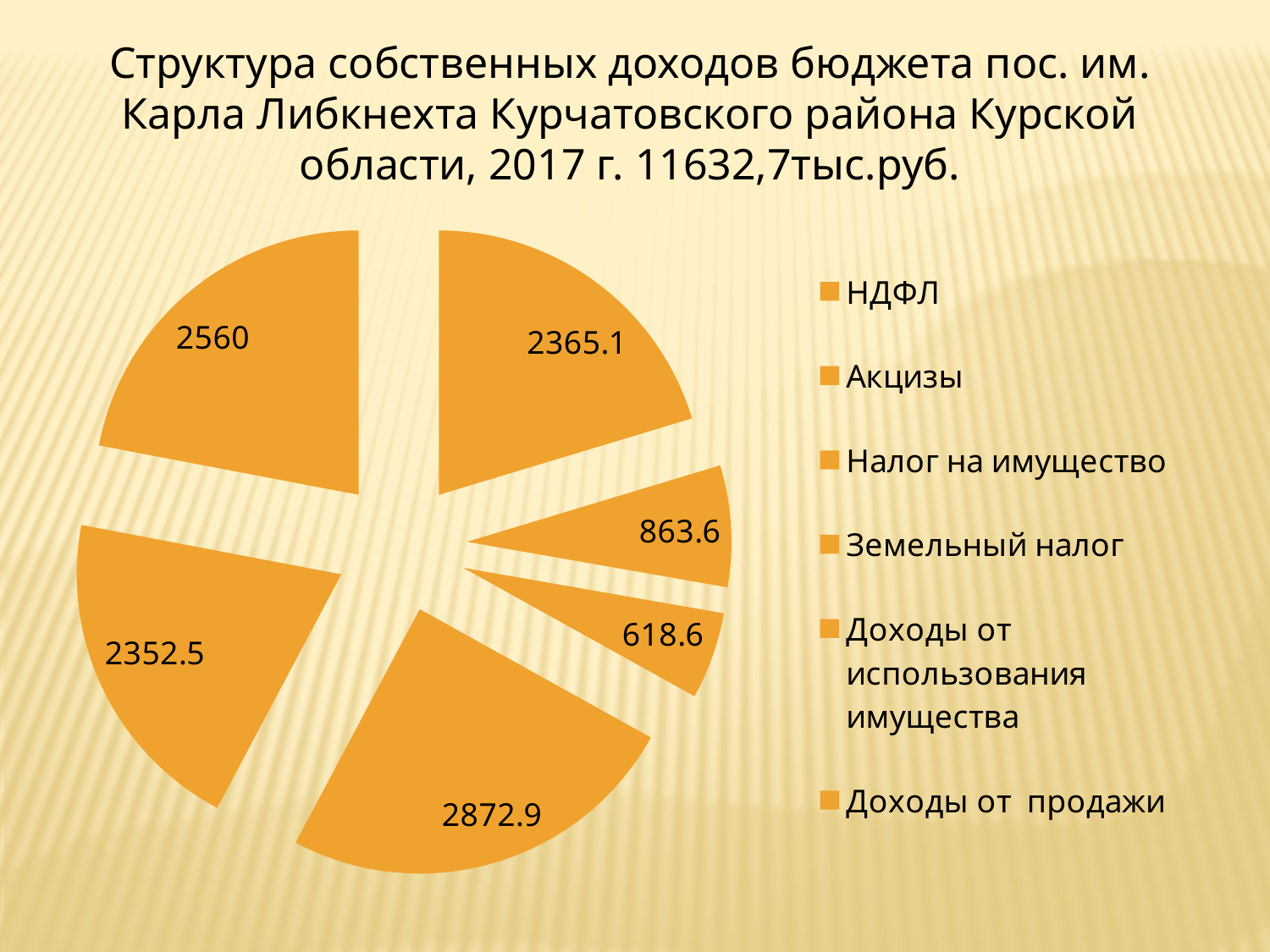
What is the first entry listed in the legend? НДФЛ What is the difference between the largest slice (2872.9) and the slice labelled 2560? 312.9 Which is larger, the slice labelled 2365.1 or the slice labelled 2352.5? 2365.1 How many entries does the legend list? 6 What share of the pie does the slice labelled 2872.9 represent? 24.7% What kind of chart is shown on the slide? pie chart What is the largest value labelled on the pie chart? 2872.9 How many slices does the pie chart have? 6 What is the smallest value labelled on the pie chart? 618.6 What is the total of all the slice values shown on the pie chart? 11632.7 Which year does the chart title refer to? 2017 What is the difference between the slices labelled 863.6 and 618.6? 245